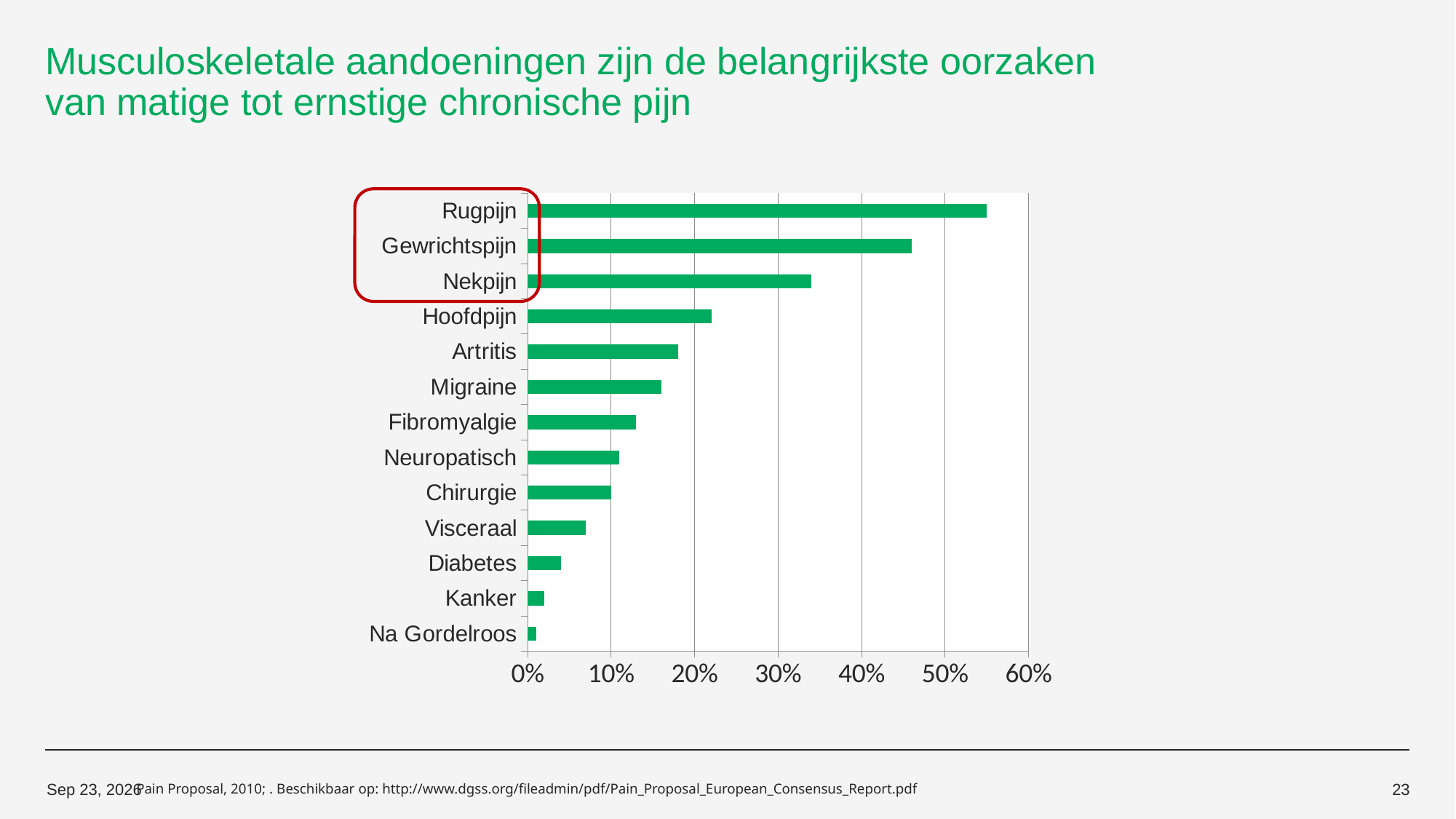
Is the value for Nekpijn greater or less than 30%? greater Which category has the highest value in the chart? Rugpijn Is the value for Diabetes greater or less than 10%? less Which three categories are enclosed by the red outline on the chart? Rugpijn, Gewrichtspijn, Nekpijn Is the value for Gewrichtspijn greater or less than 50%? less Do the bar values increase or decrease going from the top category to the bottom category? Decrease What kind of chart is shown on the slide? Bar chart How many categories are plotted in the chart? 13 Which has a larger value, Hoofdpijn or Artritis? Hoofdpijn Which category has the lowest value in the chart? Na Gordelroos